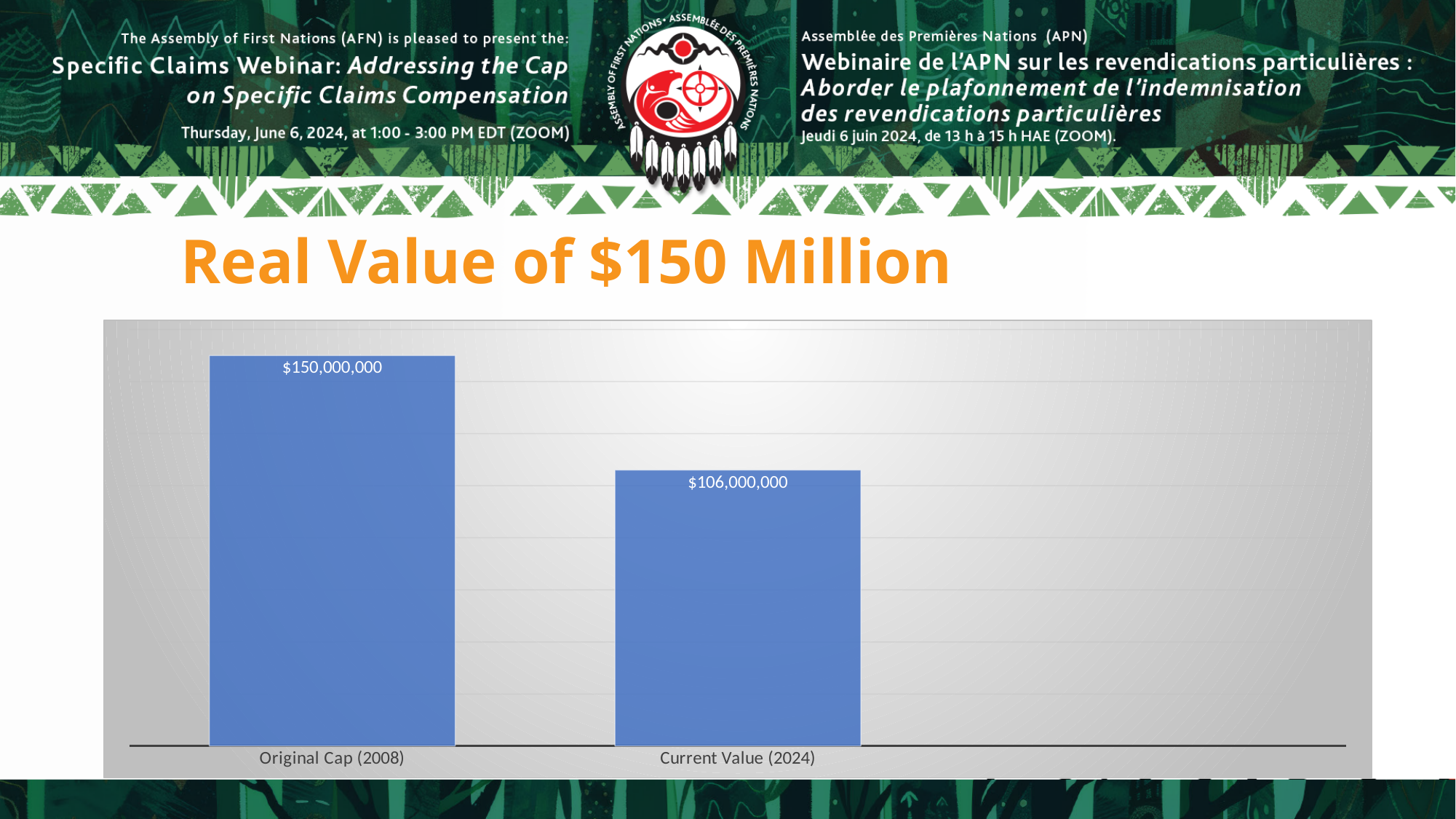
Which category has the highest value? Original Cap (2008) How many categories are plotted in the chart? 2 What is the value shown for Current Value (2024)? $106,000,000 What is the title of the slide above the chart? Real Value of $150 Million What kind of chart is shown on the slide? Bar chart What colour are the bars in the chart? Blue What is the difference between the Original Cap (2008) and the Current Value (2024)? $44,000,000 Which is larger, the Original Cap (2008) or the Current Value (2024)? Original Cap (2008) Do the values rise or fall from Original Cap (2008) to Current Value (2024)? Fall What is the value shown for Original Cap (2008)? $150,000,000 Which category has the lowest value? Current Value (2024)